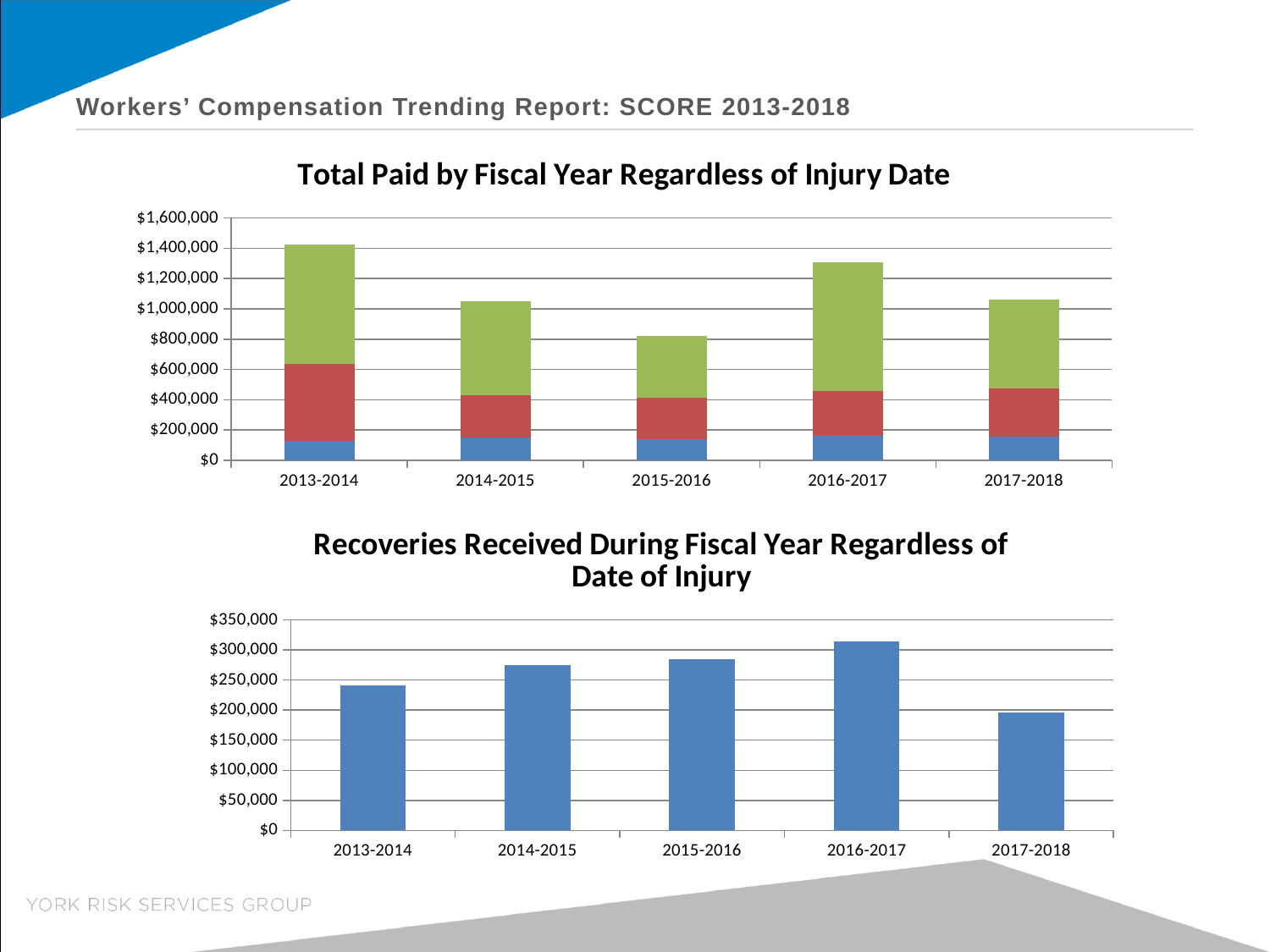
In the 'Recoveries Received During Fiscal Year Regardless of Date of Injury' chart, which fiscal year has the highest value? 2016-2017 In the 'Total Paid by Fiscal Year Regardless of Injury Date' chart, how many fiscal years are plotted? 5 In the 'Total Paid by Fiscal Year Regardless of Injury Date' chart, is the total for 2015-2016 greater or less than $1,000,000? less In the 'Total Paid by Fiscal Year Regardless of Injury Date' chart, what kind of chart is shown? Stacked bar chart In the 'Recoveries Received During Fiscal Year Regardless of Date of Injury' chart, what kind of chart is shown? Bar chart In the 'Total Paid by Fiscal Year Regardless of Injury Date' chart, which fiscal year has the highest total bar? 2013-2014 In the 'Recoveries Received During Fiscal Year Regardless of Date of Injury' chart, which fiscal year has the lowest value? 2017-2018 In the 'Recoveries Received During Fiscal Year Regardless of Date of Injury' chart, do the values rise or fall from 2016-2017 to 2017-2018? fall In the 'Recoveries Received During Fiscal Year Regardless of Date of Injury' chart, is the value for 2015-2016 greater or less than $250,000? greater In the 'Total Paid by Fiscal Year Regardless of Injury Date' chart, which fiscal year has the lowest total bar? 2015-2016 In the 'Total Paid by Fiscal Year Regardless of Injury Date' chart, is the total for 2016-2017 greater or less than $1,200,000? greater In the 'Total Paid by Fiscal Year Regardless of Injury Date' chart, which is larger, the total for 2013-2014 or the total for 2014-2015? 2013-2014